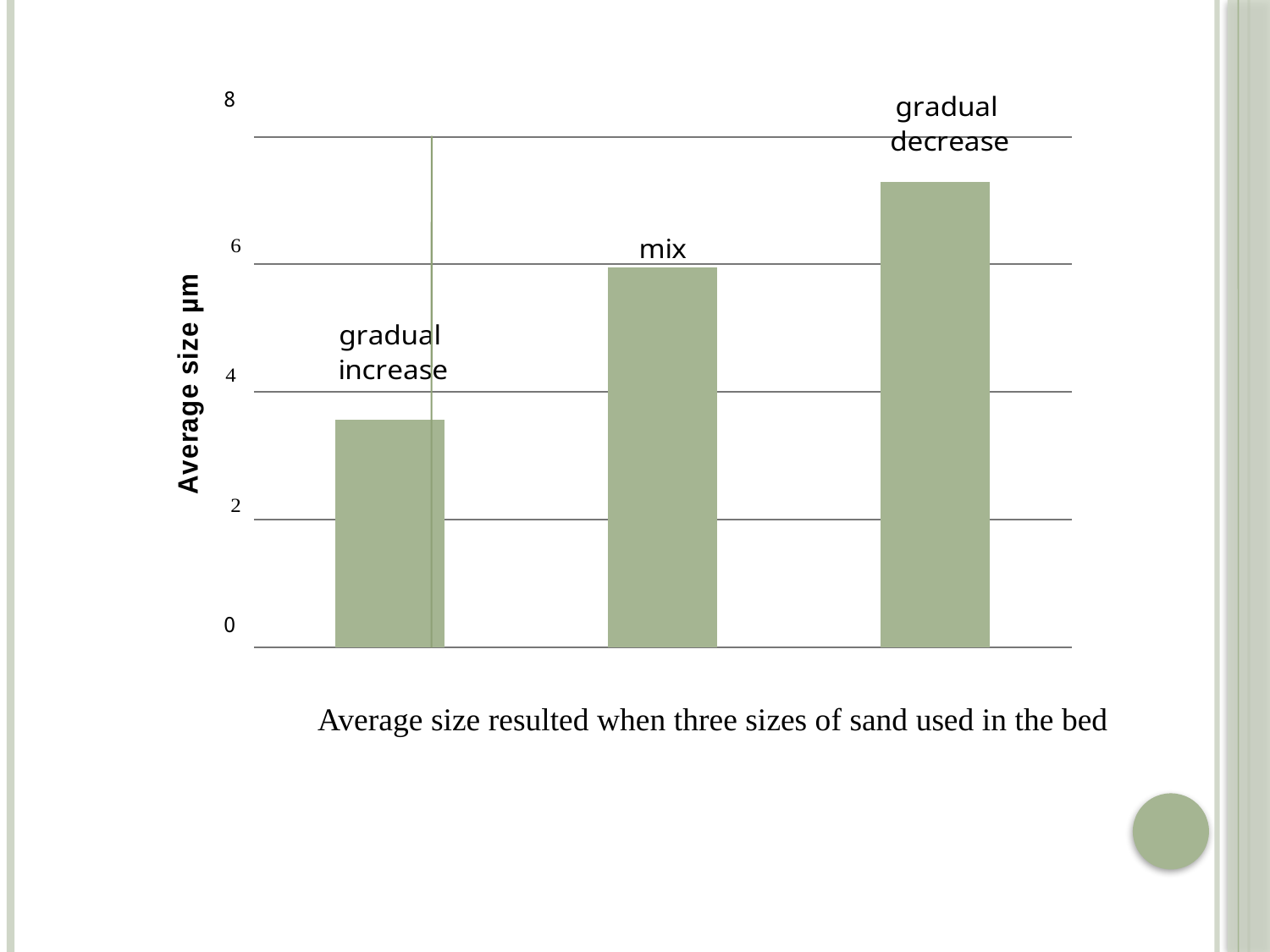
Which is larger, the value for mix or the value for gradual increase? mix How many bars (categories) does the chart show? 3 Which category has the lowest average size? gradual increase Do the bar values rise or fall from left to right across the chart? rise Is the value for gradual decrease greater or less than 8? less Which is larger, the value for gradual decrease or the value for mix? gradual decrease Is the value for gradual decrease greater or less than 6? greater Is the value for gradual increase greater or less than 4? less What kind of chart is shown on the slide? bar chart Which category has the highest average size? gradual decrease What is the label on the vertical axis of the chart? Average size μm